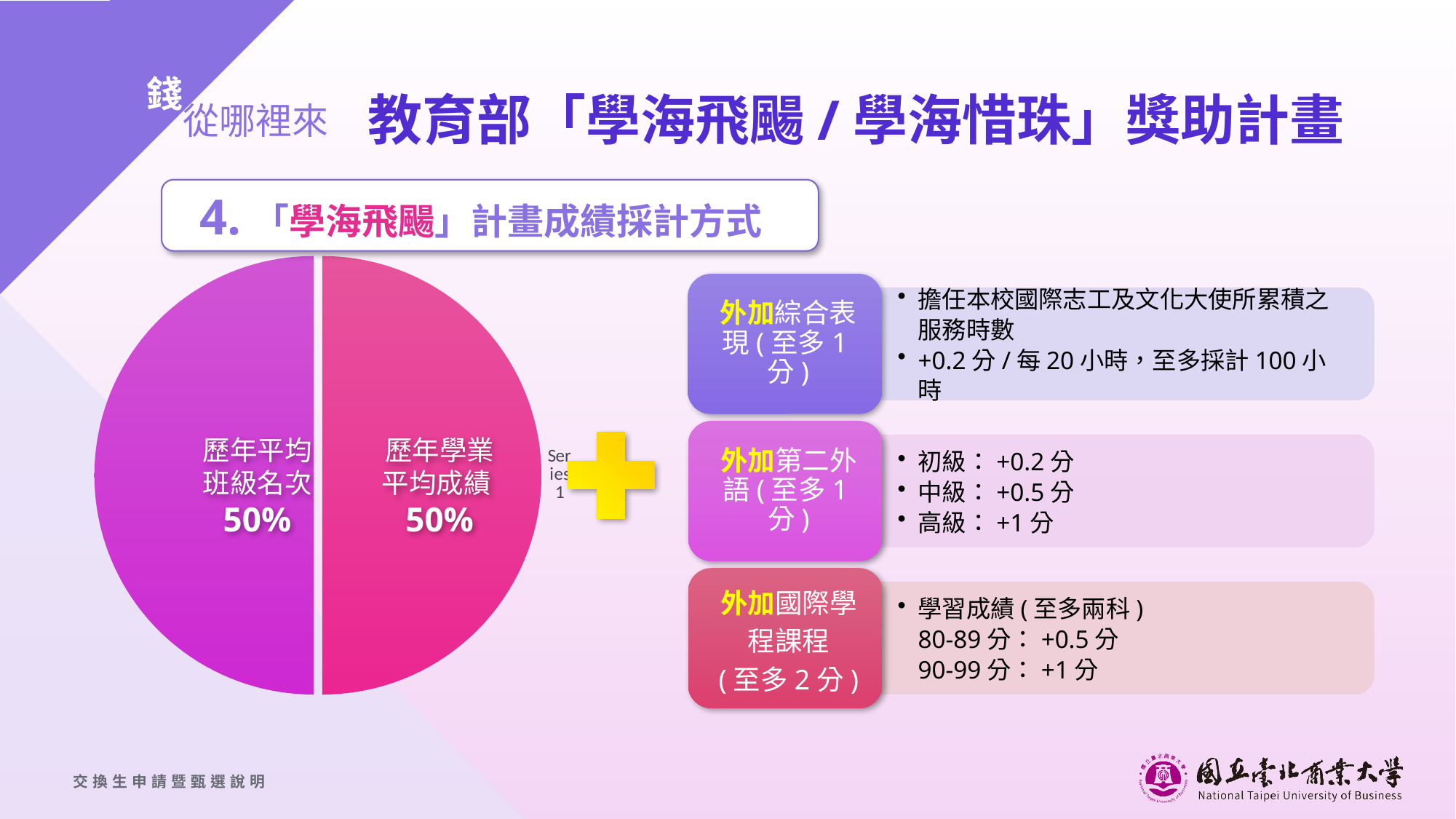
How many slices does the pie chart have? 2 Are the two slices of the pie chart equal in size? yes What is the value shown for the 歷年學業平均成績 slice? 50% Which slice of the pie chart is on the left side? 歷年平均班級名次 What share of the pie does 歷年學業平均成績 represent? 50% What kind of chart is shown on the slide? pie chart What is the combined share of the two slices in the pie chart? 100% What is the value shown for the 歷年平均班級名次 slice? 50% What series label appears next to the pie chart? Series 1 What share of the pie does 歷年平均班級名次 represent? 50%